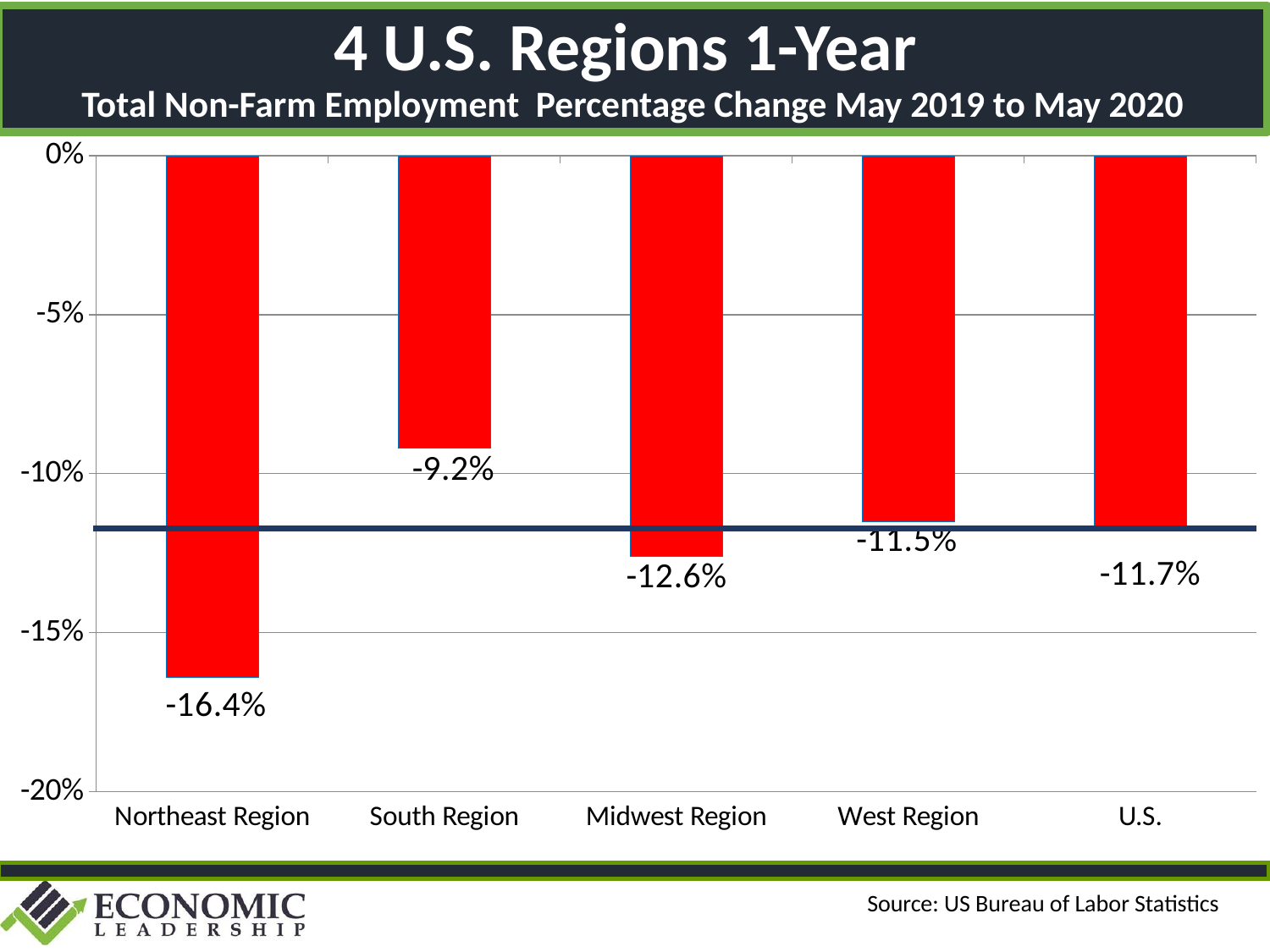
What is the percentage change in total non-farm employment for the Northeast Region? -16.4% Which category shows the smallest decline in total non-farm employment? South Region How many categories are shown on the x axis of the chart? 5 What is the percentage change in total non-farm employment for the South Region? -9.2% What is the source cited for the chart data? US Bureau of Labor Statistics What is the percentage change in total non-farm employment for the U.S. overall? -11.7% Which category shows the largest decline in total non-farm employment? Northeast Region What is the percentage change in total non-farm employment for the Midwest Region? -12.6% Which had a larger decline in employment, the Midwest Region or the West Region? Midwest Region What kind of chart is shown on the slide? Bar chart What is the difference in percentage points between the Northeast Region and the South Region? 7.2 percentage points What is the percentage change in total non-farm employment for the West Region? -11.5%